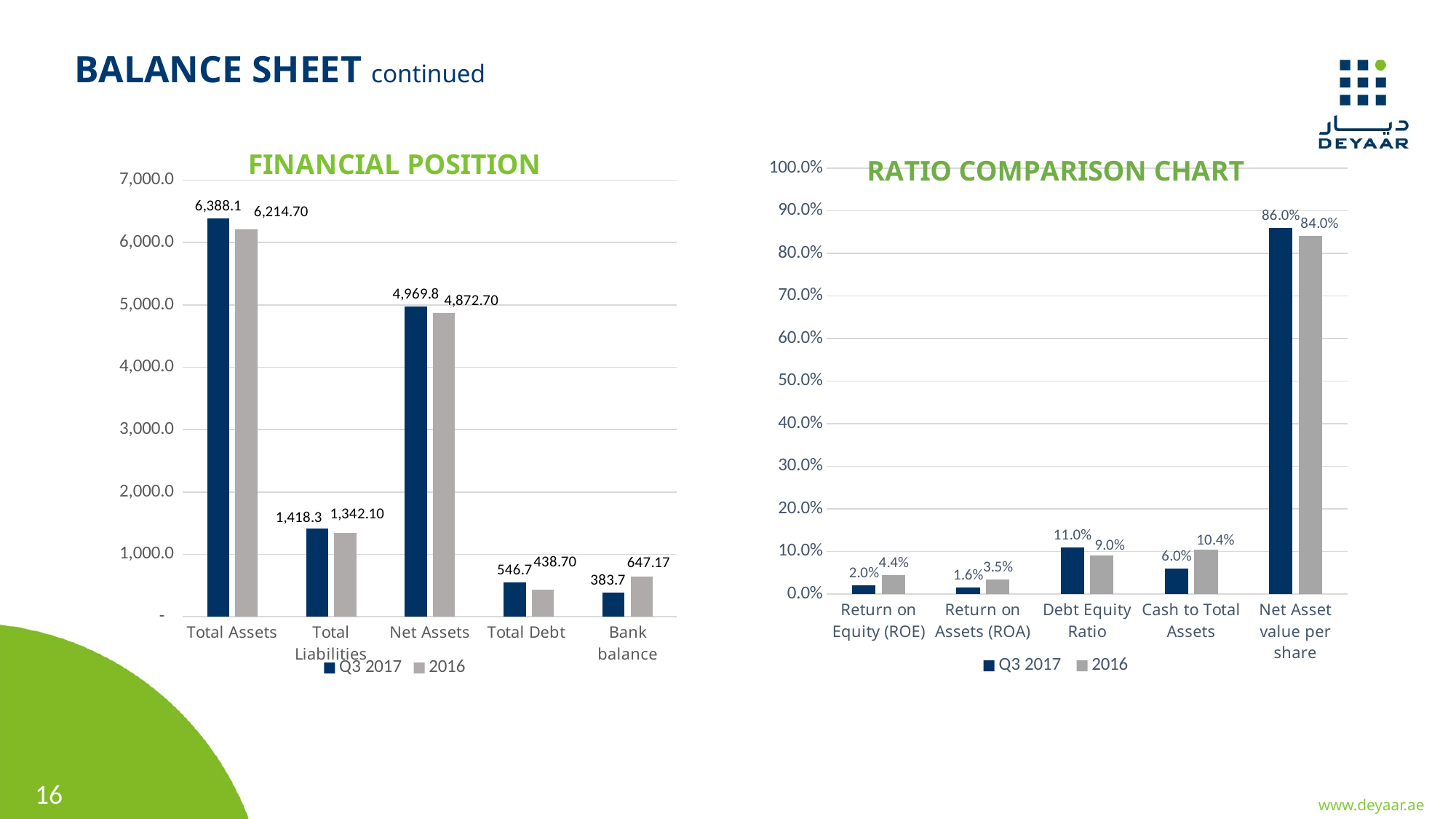
How many series does the legend of the RATIO COMPARISON CHART list? 2 In the RATIO COMPARISON CHART, what is the 2016 value for Cash to Total Assets? 10.4% In the RATIO COMPARISON CHART, what is the Q3 2017 value for Debt Equity Ratio? 11.0% In the FINANCIAL POSITION chart, is the Q3 2017 value for Total Debt larger or smaller than the 2016 value? larger How many categories are shown in the FINANCIAL POSITION chart? 5 In the RATIO COMPARISON CHART, which category has the lowest Q3 2017 value? Return on Assets (ROA) In the RATIO COMPARISON CHART, what is the difference between the Q3 2017 and 2016 values for Net Asset value per share? 2.0% In the FINANCIAL POSITION chart, which category has the lowest Q3 2017 value? Bank balance In the FINANCIAL POSITION chart, what is the Q3 2017 value for Total Assets? 6,388.1 In the FINANCIAL POSITION chart, what is the 2016 value for Bank balance? 647.17 In the FINANCIAL POSITION chart, what is the difference between the Q3 2017 and 2016 values for Total Liabilities? 76.2 In the FINANCIAL POSITION chart, which category has the highest Q3 2017 value? Total Assets